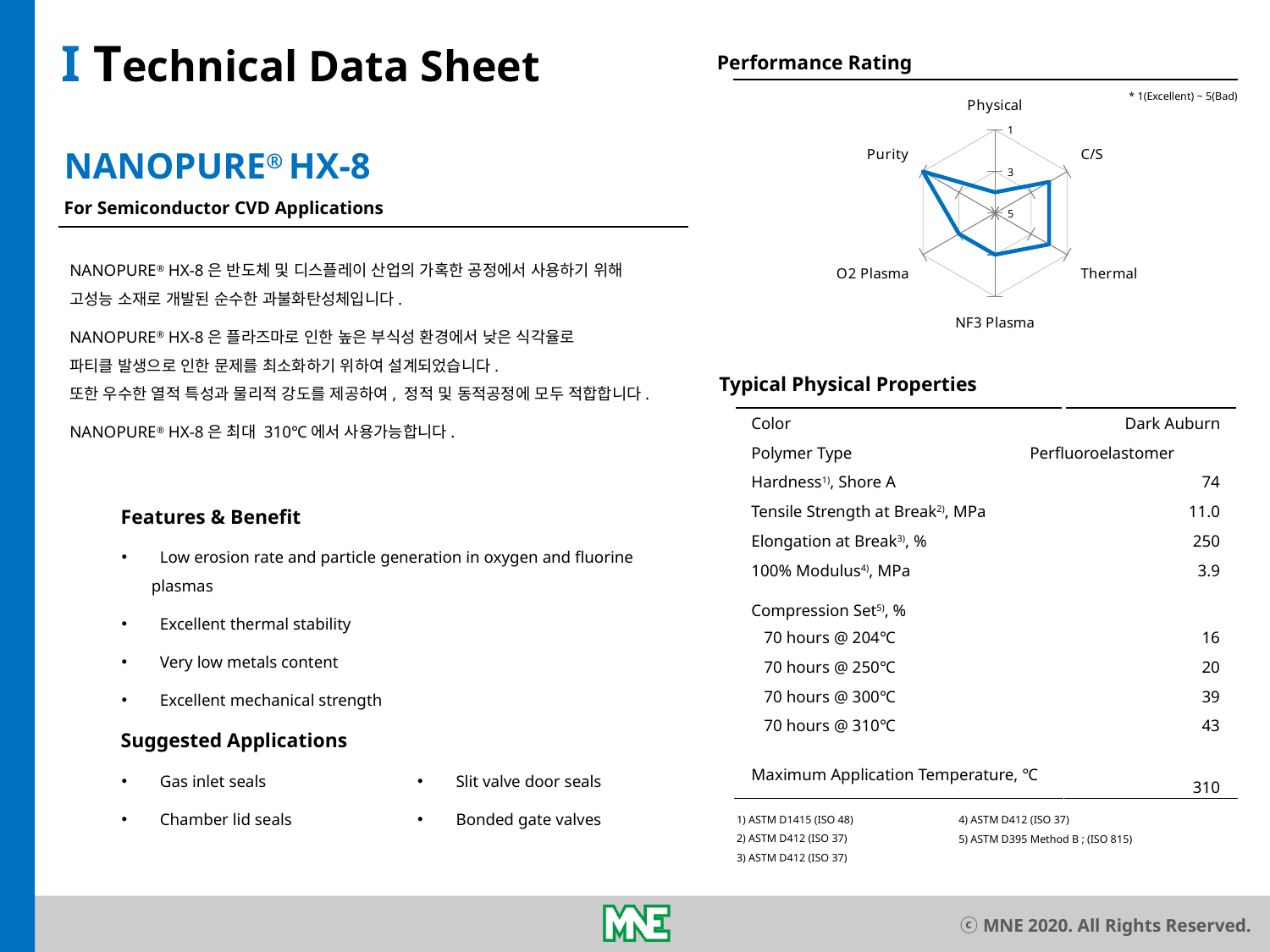
In the Performance Rating chart, is the value for Purity greater or less than 3? less In the Performance Rating chart, is the value for C/S greater or less than 3? less In the Performance Rating chart, which has the lower rating value, Purity or Physical? Purity How many categories (axes) does the Performance Rating radar chart have? 6 In the Performance Rating chart, which has the lower rating value, Thermal or O2 Plasma? Thermal According to the note on the Performance Rating chart, what rating value means Excellent and what value means Bad? 1 (Excellent) ~ 5 (Bad) In the Performance Rating chart, which has the lower rating value, C/S or NF3 Plasma? C/S What kind of chart is shown under the heading "Performance Rating"? Radar chart In the Performance Rating chart, is the value for Thermal greater or less than 3? less What is the title of the chart on the slide? Performance Rating Which category is plotted at the top of the Performance Rating radar chart? Physical